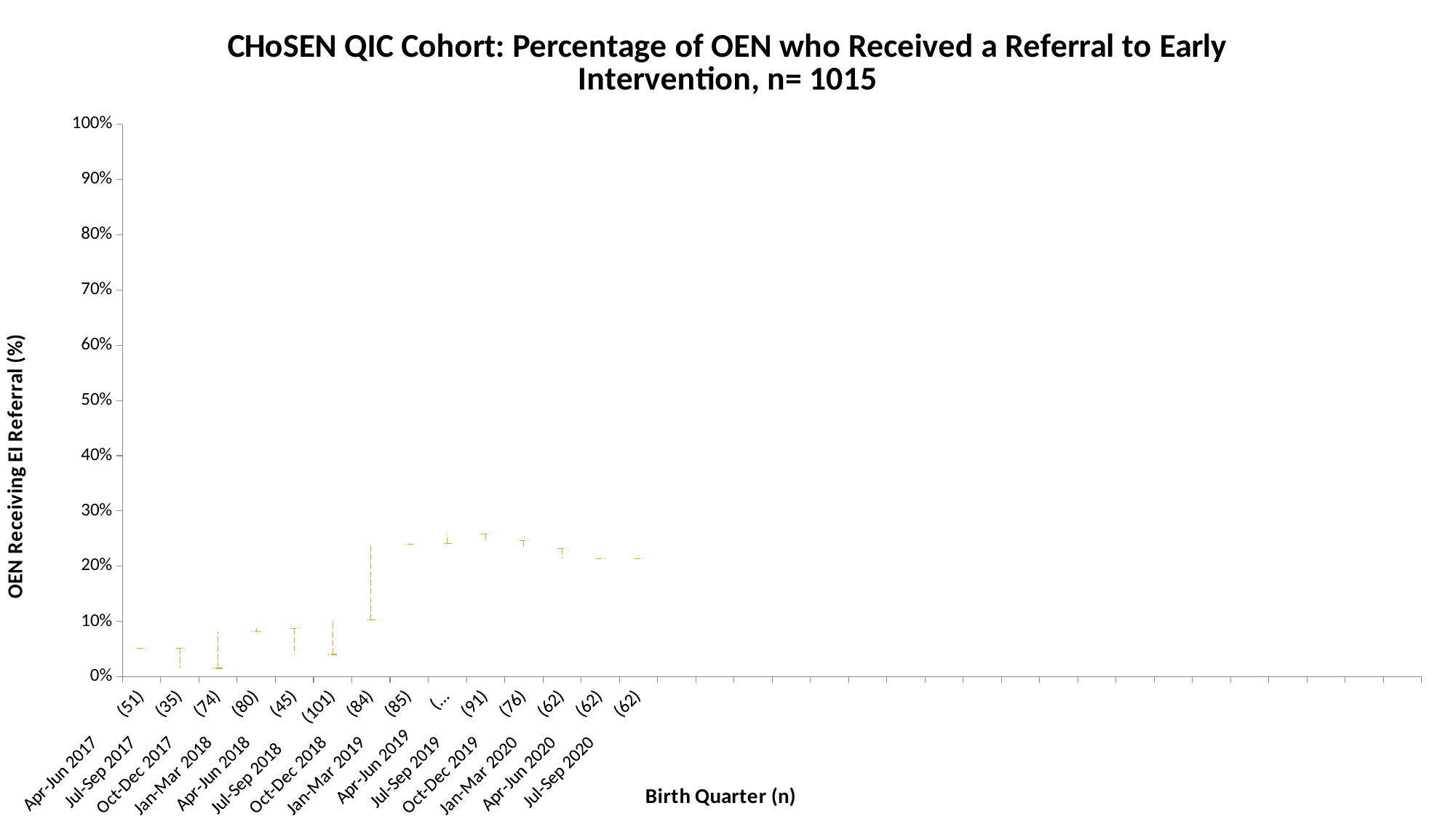
What is the n shown in parentheses for the Oct-Dec 2018 birth quarter? (84) Which has the larger value, Apr-Jun 2017 or Oct-Dec 2019? Oct-Dec 2019 What is the title of the chart? CHoSEN QIC Cohort: Percentage of OEN who Received a Referral to Early Intervention, n= 1015 Is the value for Jul-Sep 2020 greater or less than 20%? greater Do the values generally rise or fall from Apr-Jun 2017 to Jul-Sep 2020? rise How many birth quarters are labelled on the x axis? 14 What is the label of the y axis? OEN Receiving EI Referral (%) Is the value for Oct-Dec 2019 greater or less than 20%? greater What kind of chart is shown on the slide? line chart